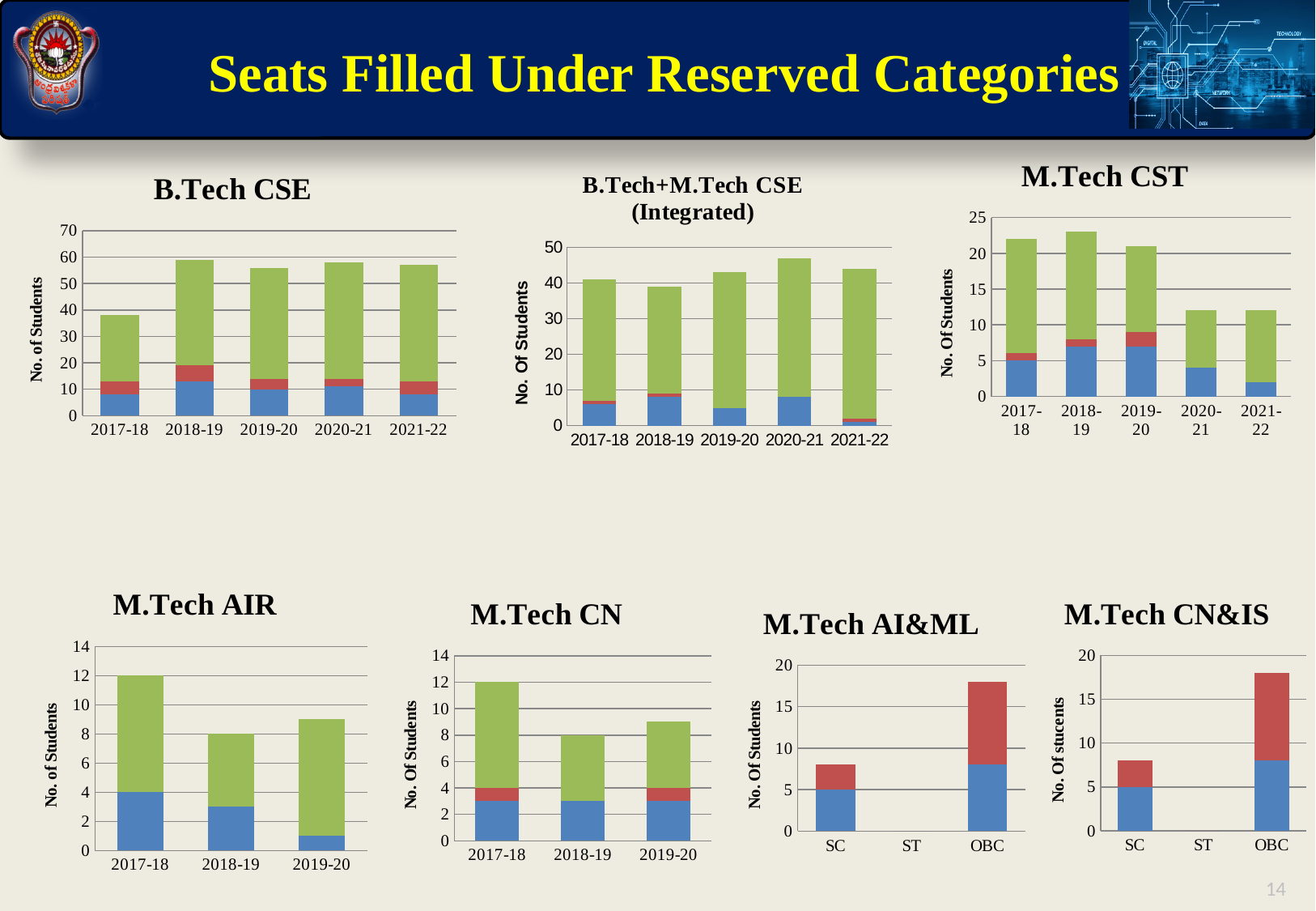
In the B.Tech CSE chart, is the total for 2018-19 greater or less than 50? greater In the M.Tech CST chart, is the total for 2020-21 greater or less than 15? less In the B.Tech CSE chart, how many academic years are shown on the x axis? 5 In the M.Tech CN&IS chart, is the value for SC greater or less than 10? less In the B.Tech+M.Tech CSE (Integrated) chart, which year has the highest total number of students? 2020-21 In the M.Tech AI&ML chart, which category has the highest number of students? OBC In the M.Tech AIR chart, which year has the highest total number of students? 2017-18 How many charts are shown on the slide? 7 What kind of chart is the B.Tech CSE chart? bar chart In the M.Tech CN chart, how many academic years are shown on the x axis? 3 In the B.Tech CSE chart, which year has the lowest total number of students? 2017-18